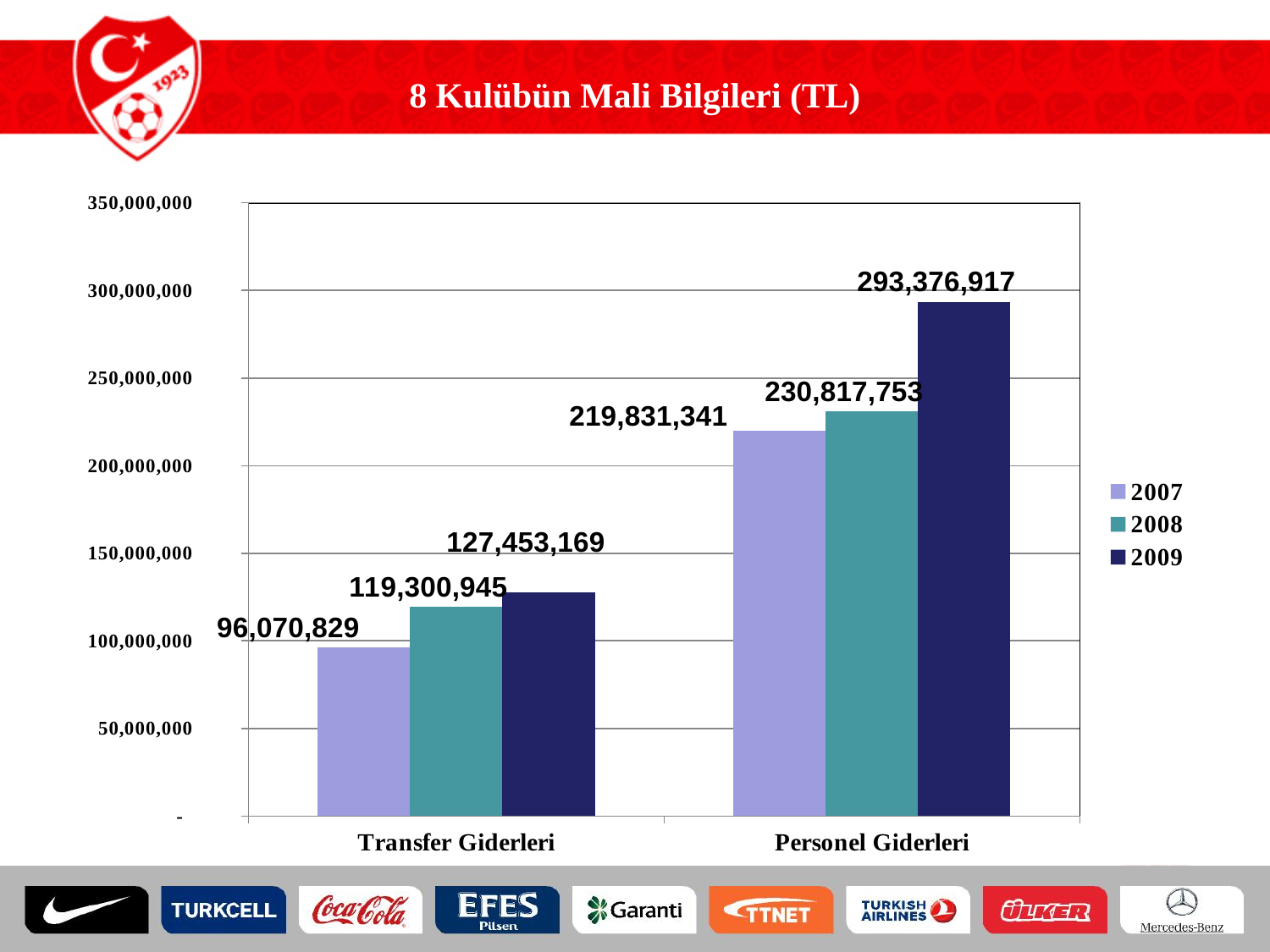
What is the value for Transfer Giderleri in 2008? 119,300,945 What is the value for Personel Giderleri in 2009? 293,376,917 What is the value for Personel Giderleri in 2007? 219,831,341 How many series does the legend list? 3 What is the title of the chart? 8 Kulübün Mali Bilgileri (TL) What is the difference between the 2009 and 2007 values for Personel Giderleri? 73,545,576 Which is larger: Transfer Giderleri in 2009 or Personel Giderleri in 2007? Personel Giderleri in 2007 Which year has the highest value for Personel Giderleri? 2009 What kind of chart is shown on the slide? Bar chart What is the value for Transfer Giderleri in 2007? 96,070,829 What is the difference between the 2009 and 2007 values for Transfer Giderleri? 31,382,340 Which year has the lowest value for Transfer Giderleri? 2007